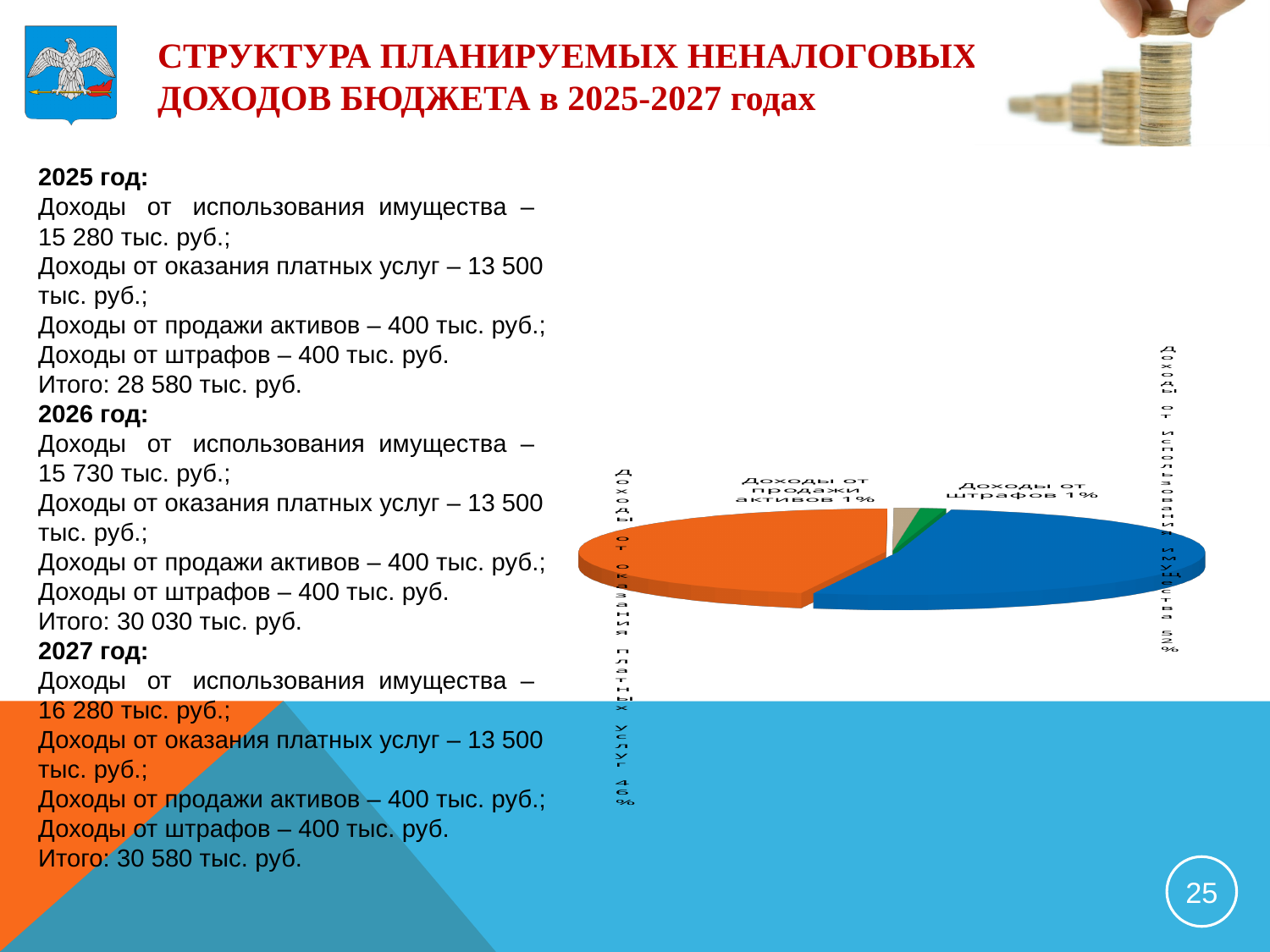
By how many percentage points does the share of Доходы от использования имущества exceed the share of Доходы от оказания платных услуг? 6 Which slice is larger: Доходы от использования имущества or Доходы от оказания платных услуг? Доходы от использования имущества How many slices does the pie chart have? 4 Which category has the largest slice in the pie chart? Доходы от использования имущества What share of the pie chart is labelled for Доходы от использования имущества? 52% What share of the pie chart is labelled for Доходы от оказания платных услуг? 46% What colour is the slice for Доходы от использования имущества? Blue What share of the pie chart is labelled for Доходы от продажи активов? 1% What colour is the slice for Доходы от оказания платных услуг? Orange Which slice is larger: Доходы от оказания платных услуг or Доходы от продажи активов? Доходы от оказания платных услуг What kind of chart is shown on the slide? Pie chart